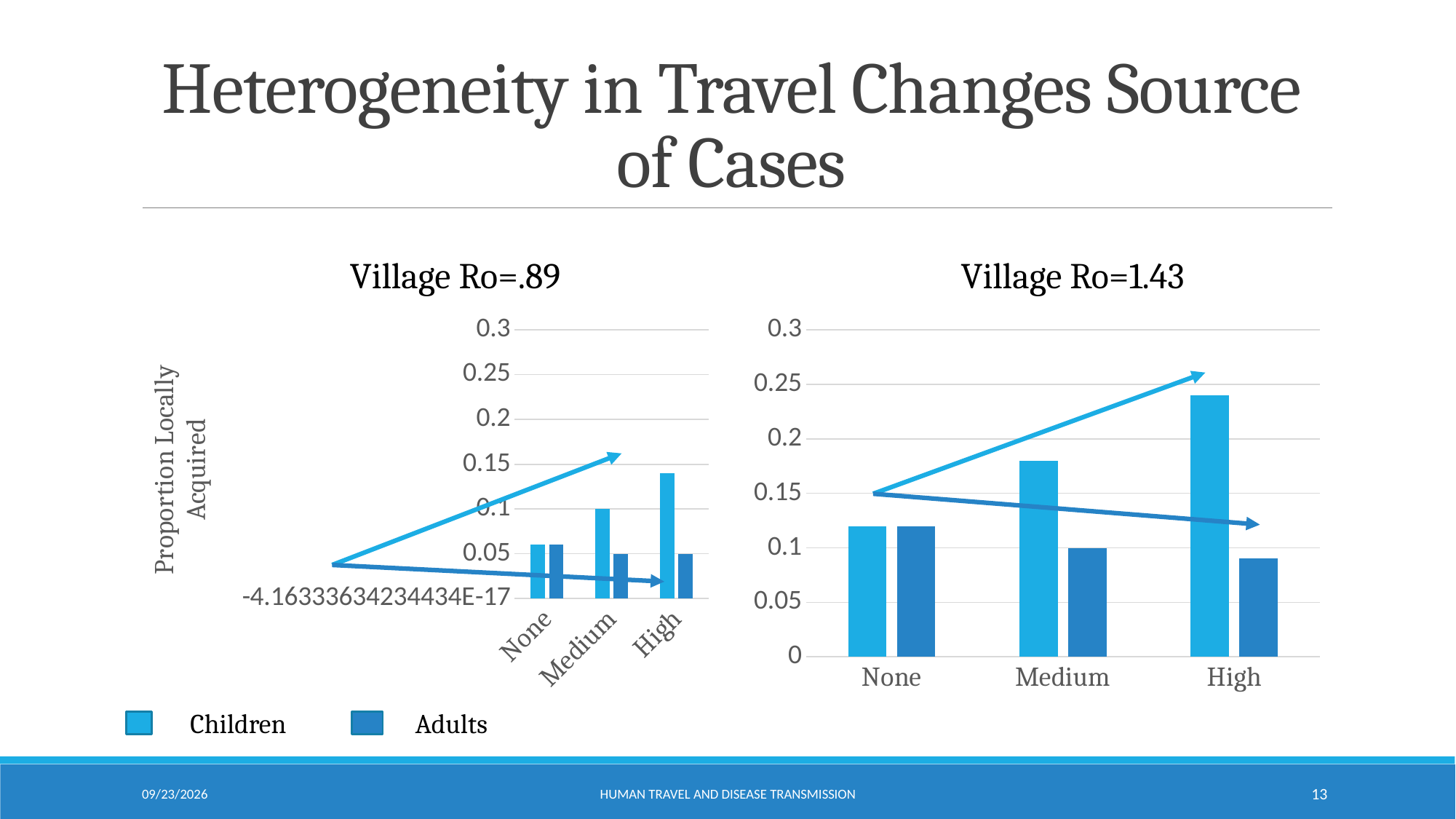
In the 'Village Ro=.89' chart, is the Children value for High greater or less than 0.1? greater In the 'Village Ro=1.43' chart, do the Adults values rise or fall from None to High? fall In the 'Village Ro=.89' chart, what is the Children value for Medium? 0.1 In the 'Village Ro=1.43' chart, how many travel categories are shown on the x axis? 3 In the 'Village Ro=.89' chart, which is larger for High: Children or Adults? Children In the 'Village Ro=1.43' chart, is the Children value for High greater or less than 0.2? greater What kind of chart is the 'Village Ro=1.43' chart? bar chart In the 'Village Ro=1.43' chart, which category has the lowest value for Adults? High In the 'Village Ro=1.43' chart, do the Children values rise or fall from None to High? rise In the 'Village Ro=1.43' chart, which category has the highest value for Children? High In the 'Village Ro=1.43' chart, what is the Adults value for Medium? 0.1 How many series does the legend list for the charts? 2